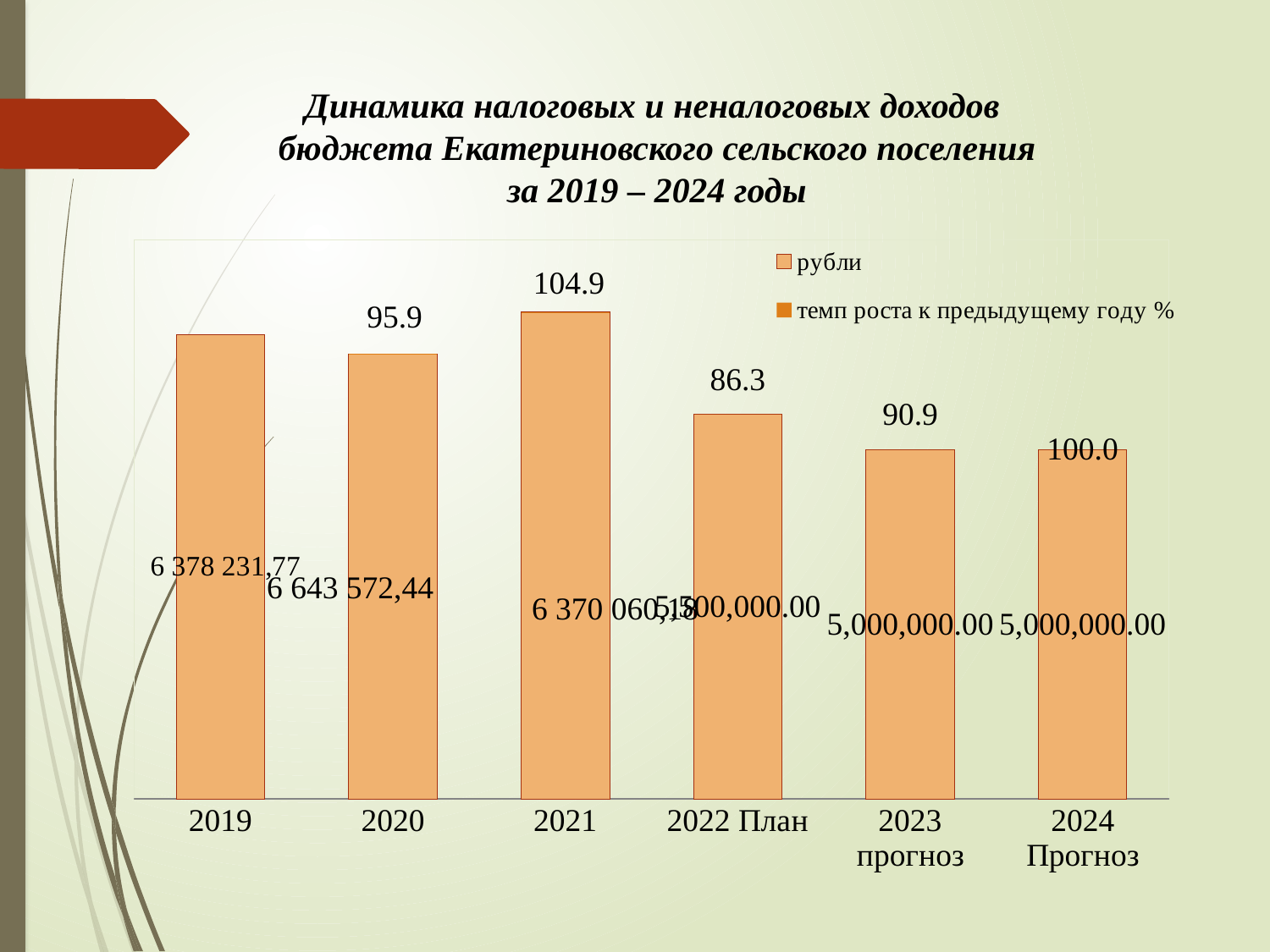
What is the growth rate to the previous year (темп роста) shown for 2022 План? 86.3 What is the growth rate to the previous year (темп роста) shown for 2021? 104.9 What is the difference between the growth rate for 2021 and the growth rate for 2022 План? 18.6 What is the growth rate to the previous year (темп роста) shown for 2024 Прогноз? 100.0 How many categories are shown along the x axis of the chart? 6 Which category has the highest growth rate to the previous year? 2021 Which has the larger growth rate to the previous year, 2020 or 2023 прогноз? 2020 How many series does the chart legend list? 2 What kind of chart is shown on the slide? bar chart What is the value in rubles shown for 2023 прогноз? 5,000,000.00 Which category has the lowest growth rate to the previous year? 2022 План